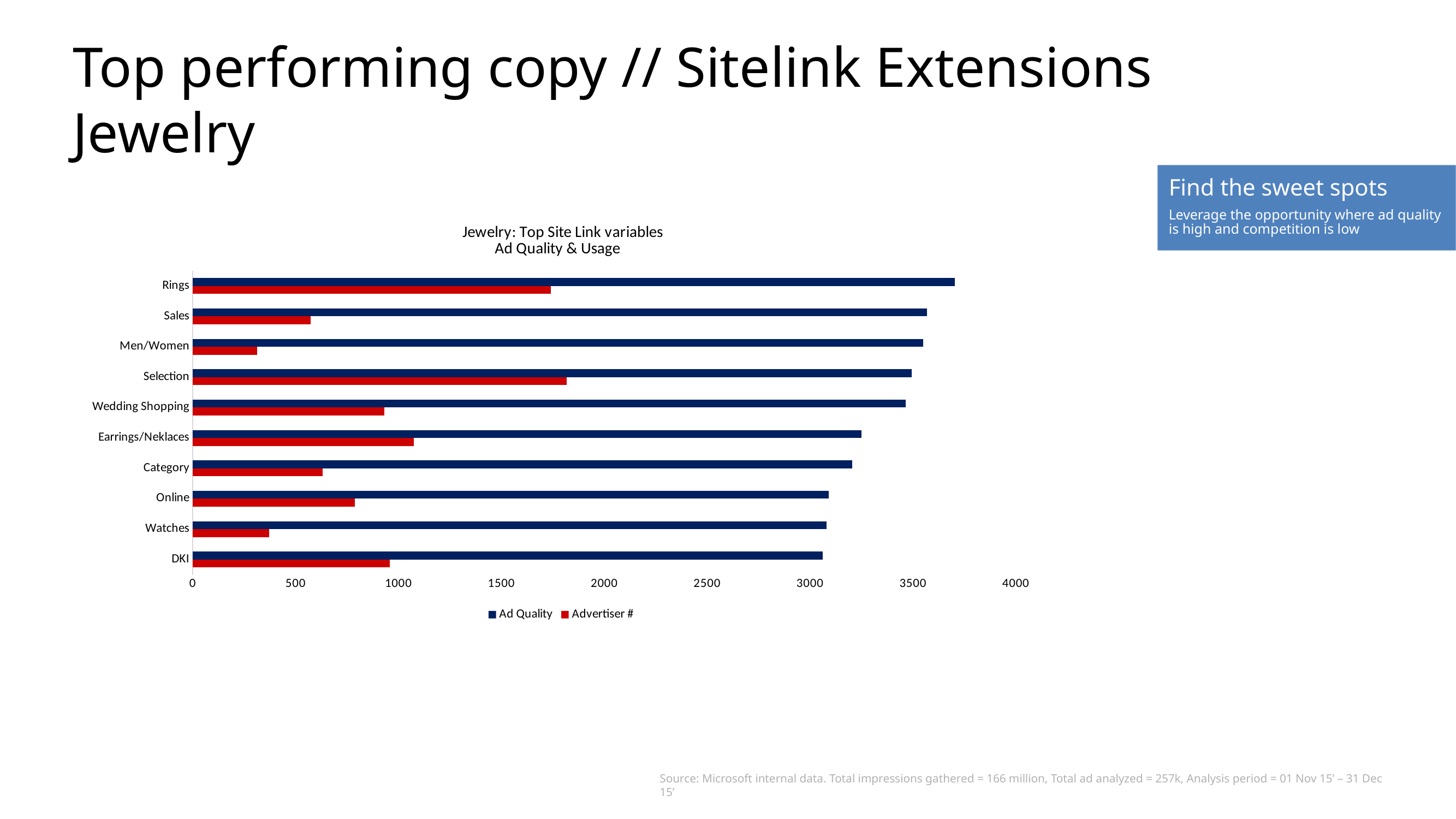
Which is larger for Rings: the Ad Quality value or the Advertiser # value? Ad Quality Is the Ad Quality value for Category greater or less than 3000? greater What is the title of the chart? Jewelry: Top Site Link variables Ad Quality & Usage Which category has the highest Ad Quality value? Rings Is the Advertiser # value for Men/Women greater or less than 500? less Is the Advertiser # value for Sales greater or less than 1000? less How many series does the chart legend list? 2 What kind of chart is shown on the slide? Bar chart How many categories are plotted on the chart? 10 Which has the larger Advertiser # value: Selection or Men/Women? Selection